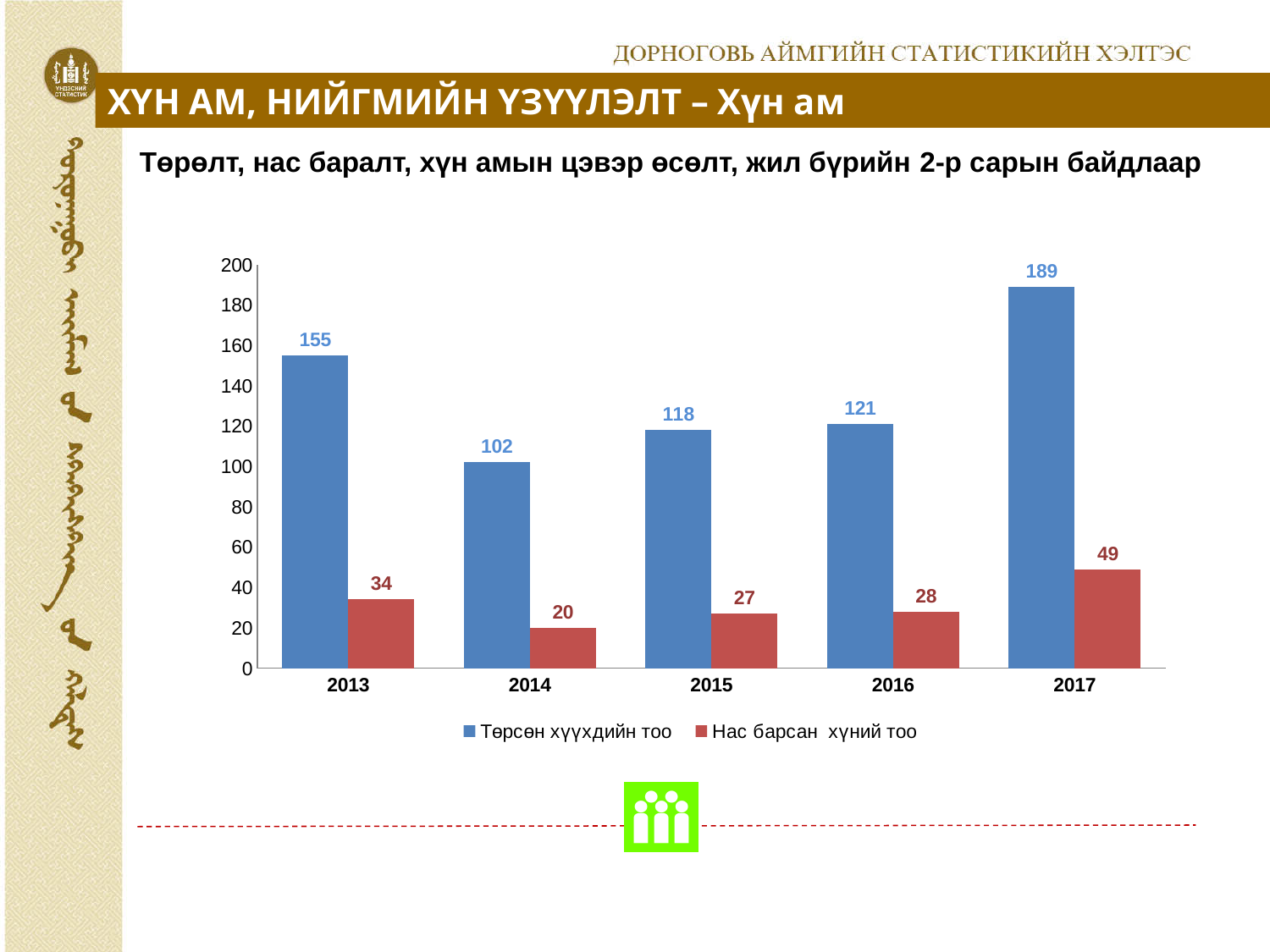
Does Нас барсан хүний тоо rise or fall from 2014 to 2017? rise What is the value of Төрсөн хүүхдийн тоо for 2015? 118 What is the value of Төрсөн хүүхдийн тоо for 2017? 189 How many years are shown on the x axis? 5 How many series does the legend list? 2 Is the value of Төрсөн хүүхдийн тоо for 2014 greater or less than 120? less What is the value of Нас барсан хүний тоо for 2014? 20 What is the difference between Төрсөн хүүхдийн тоо and Нас барсан хүний тоо in 2013? 121 Which is larger: Төрсөн хүүхдийн тоо in 2016 or in 2015? 2016 What kind of chart is shown on the slide? bar chart Which year has the lowest value for Нас барсан хүний тоо? 2014 Which year has the highest value for Төрсөн хүүхдийн тоо? 2017